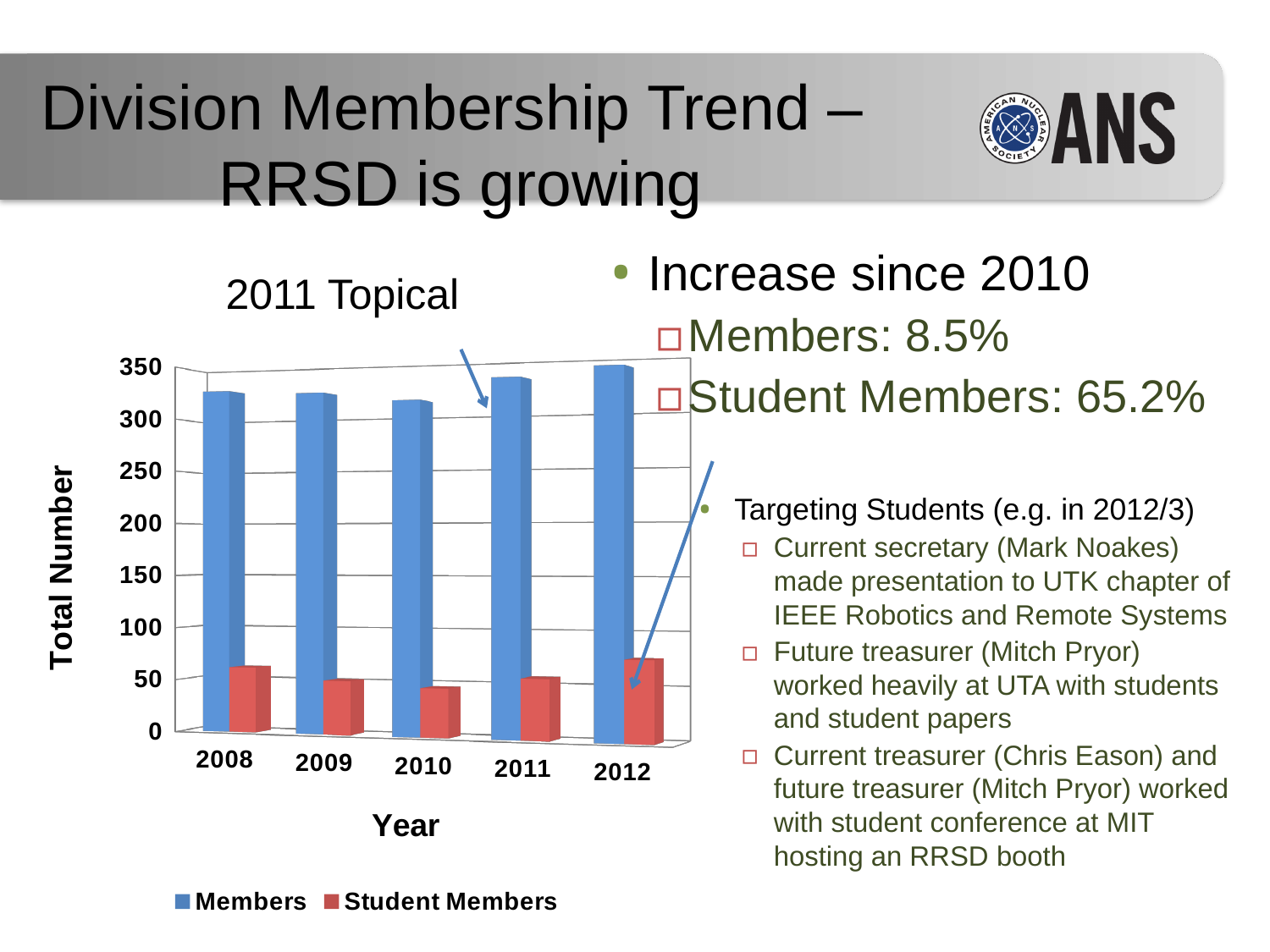
Which is larger in 2008: Student Members or Student Members in 2009? Student Members in 2008 Is the value for Members in 2010 greater or less than 300? greater Is the value for Student Members in 2012 greater or less than 50? greater Do the values for Members rise or fall from 2010 to 2012? rise How many years are shown on the x axis of the chart? 5 What is the title of the chart's vertical axis? Total Number Which year has the lowest value for Student Members? 2010 Which year has the highest value for Student Members? 2012 Which year has the highest value for Members? 2012 What kind of chart is shown on the slide? bar chart How many series does the chart's legend list? 2